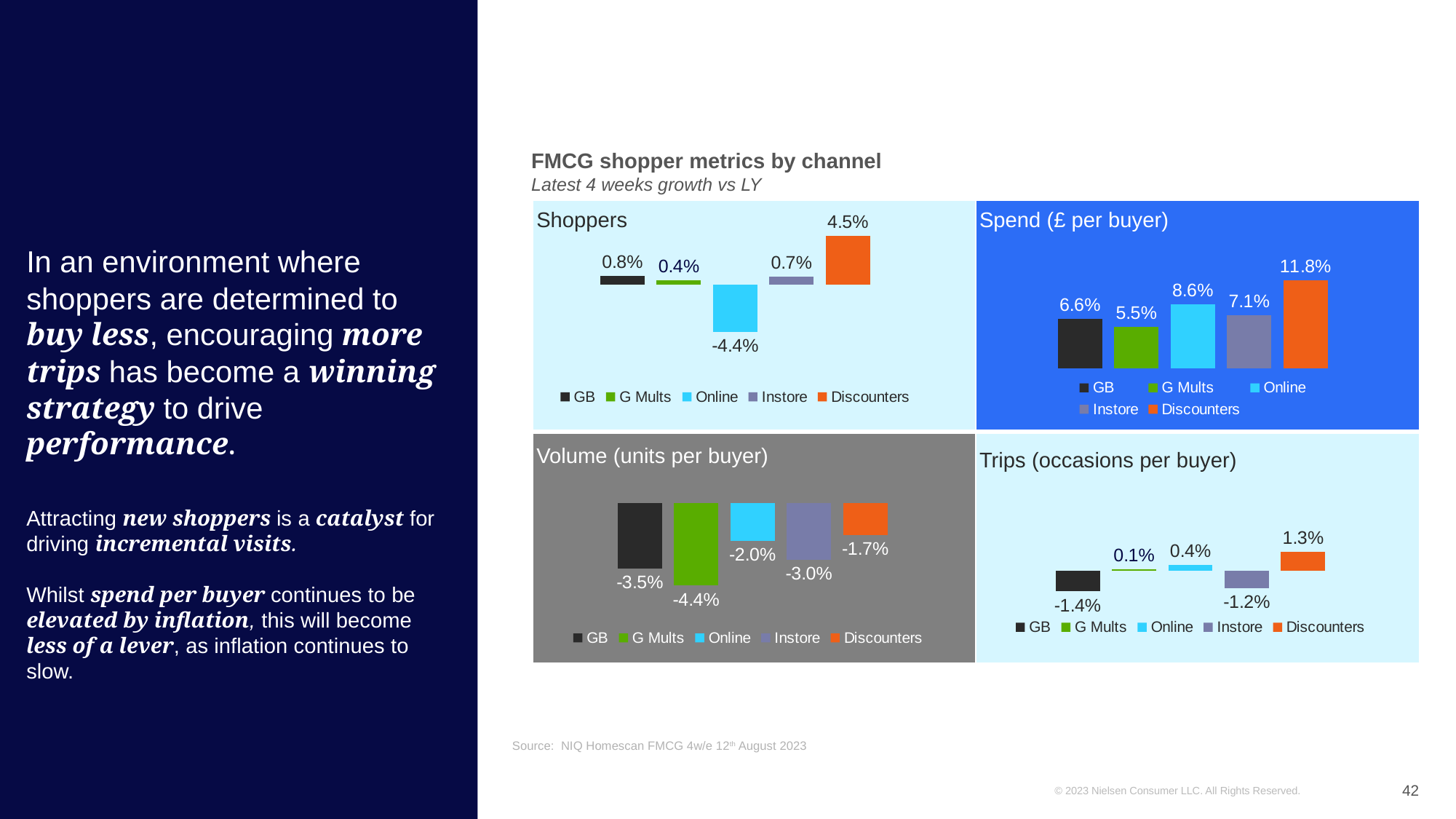
In the Spend (£ per buyer) chart, what is the value for G Mults? 5.5% In the Trips (occasions per buyer) chart, which is larger, the value for Online or the value for Discounters? Discounters In the Spend (£ per buyer) chart, what is the difference between Online and Instore? 1.5% In the Volume (units per buyer) chart, what is the value for Instore? -3.0% What is the subtitle shown under the title 'FMCG shopper metrics by channel'? Latest 4 weeks growth vs LY What kind of chart is the Spend (£ per buyer) chart? Bar chart In the Spend (£ per buyer) chart, which channel has the highest value? Discounters In the Trips (occasions per buyer) chart, what is the value for GB? -1.4% How many series does the legend of the Shoppers chart list? 5 In the Shoppers chart, what is the value for Online? -4.4% In the Shoppers chart, what is the value for Discounters? 4.5% In the Volume (units per buyer) chart, which channel has the lowest value? G Mults